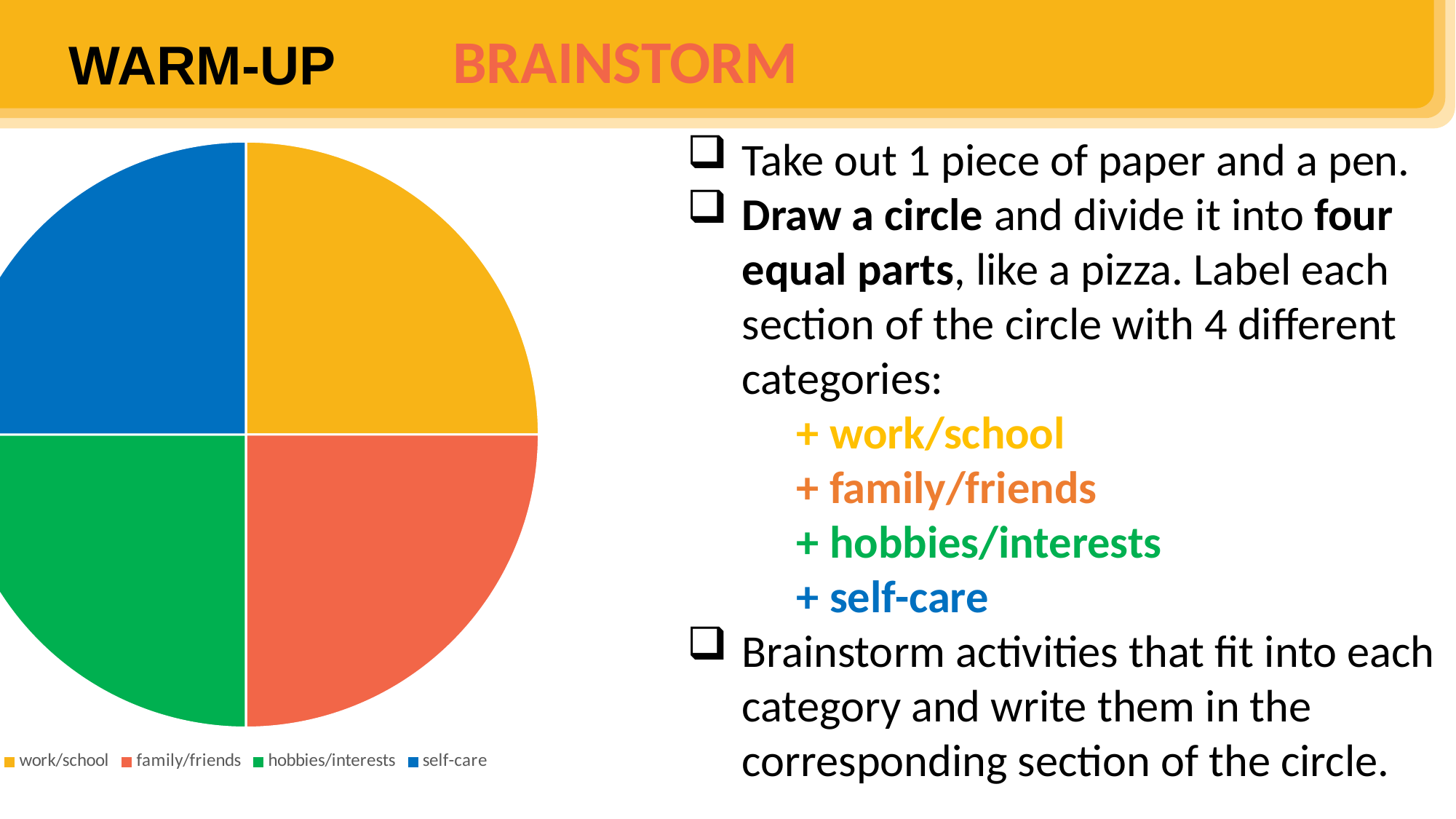
Which legend entry is shown in blue in the pie chart? self-care What kind of chart is shown on the slide? pie chart Which category is listed last in the pie chart's legend? self-care Which category is listed first in the pie chart's legend? work/school Are the four slices of the pie chart equal in size? yes How many slices does the pie chart have? 4 How many entries does the pie chart's legend list? 4